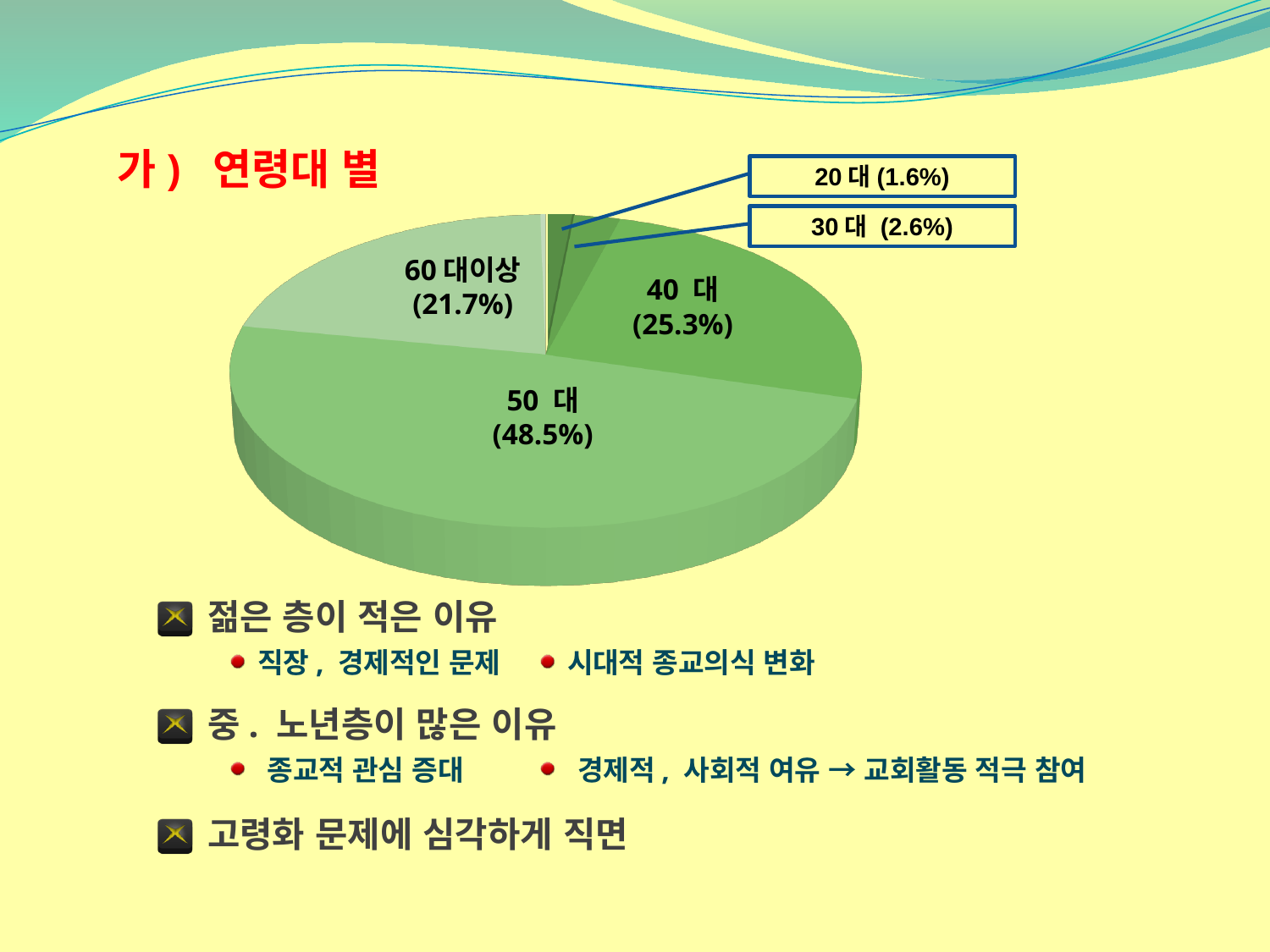
Which age group has the largest slice of the pie? 50대 What is the difference in percentage points between the 50대 and 40대 slices? 23.2 What is the title shown above the pie chart? 가) 연령대 별 Which age group has the smallest slice of the pie? 20대 What share of the pie does the 30대 slice represent? 2.6% What kind of chart is shown on the slide? Pie chart What share of the pie does the 20대 slice represent? 1.6% What share of the pie does the 60대이상 slice represent? 21.7% What share of the pie does the 40대 slice represent? 25.3% Which slice is larger, 40대 or 60대이상? 40대 What share of the pie does the 50대 slice represent? 48.5% How many age-group slices does the pie chart have? 5